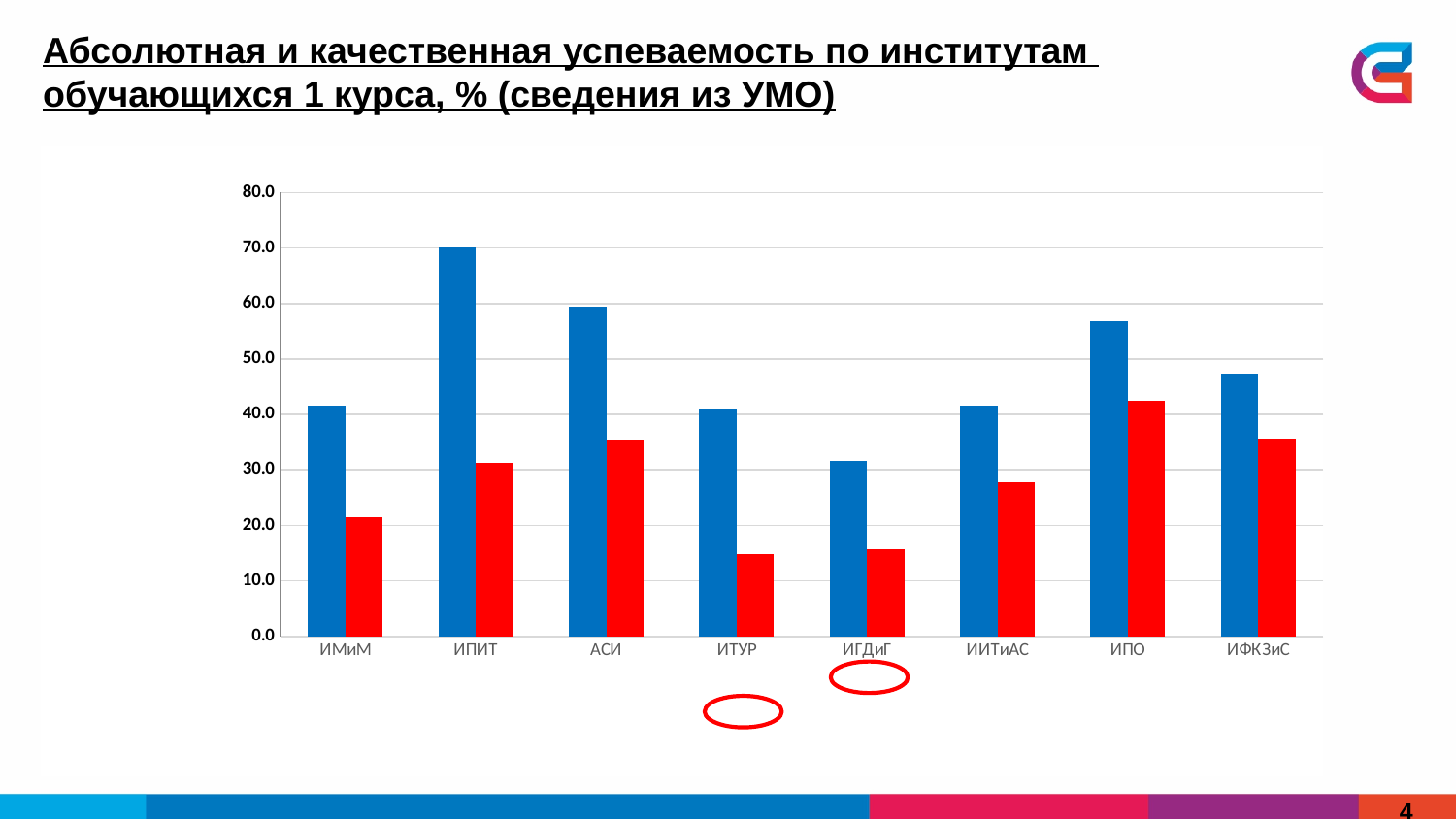
What kind of chart is shown on the slide? bar chart How many institutes (categories) are shown on the x axis? 8 Is the value of the red bar for ИТУР greater or less than 20.0? less Is the value of the blue bar for ИПО greater or less than 50.0? greater Which institute has the shortest blue bar? ИГДиГ Is the blue bar for ИПИТ taller or shorter than the blue bar for АСИ? taller Is the red bar for ИПО taller or shorter than the red bar for ИИТиАС? taller Is the value of the blue bar for ИФКЗиС greater or less than 40.0? greater How many bars are plotted for each institute? 2 What is the highest value shown on the vertical axis? 80.0 Which institute has the tallest red bar? ИПО Which institute has the tallest blue bar? ИПИТ